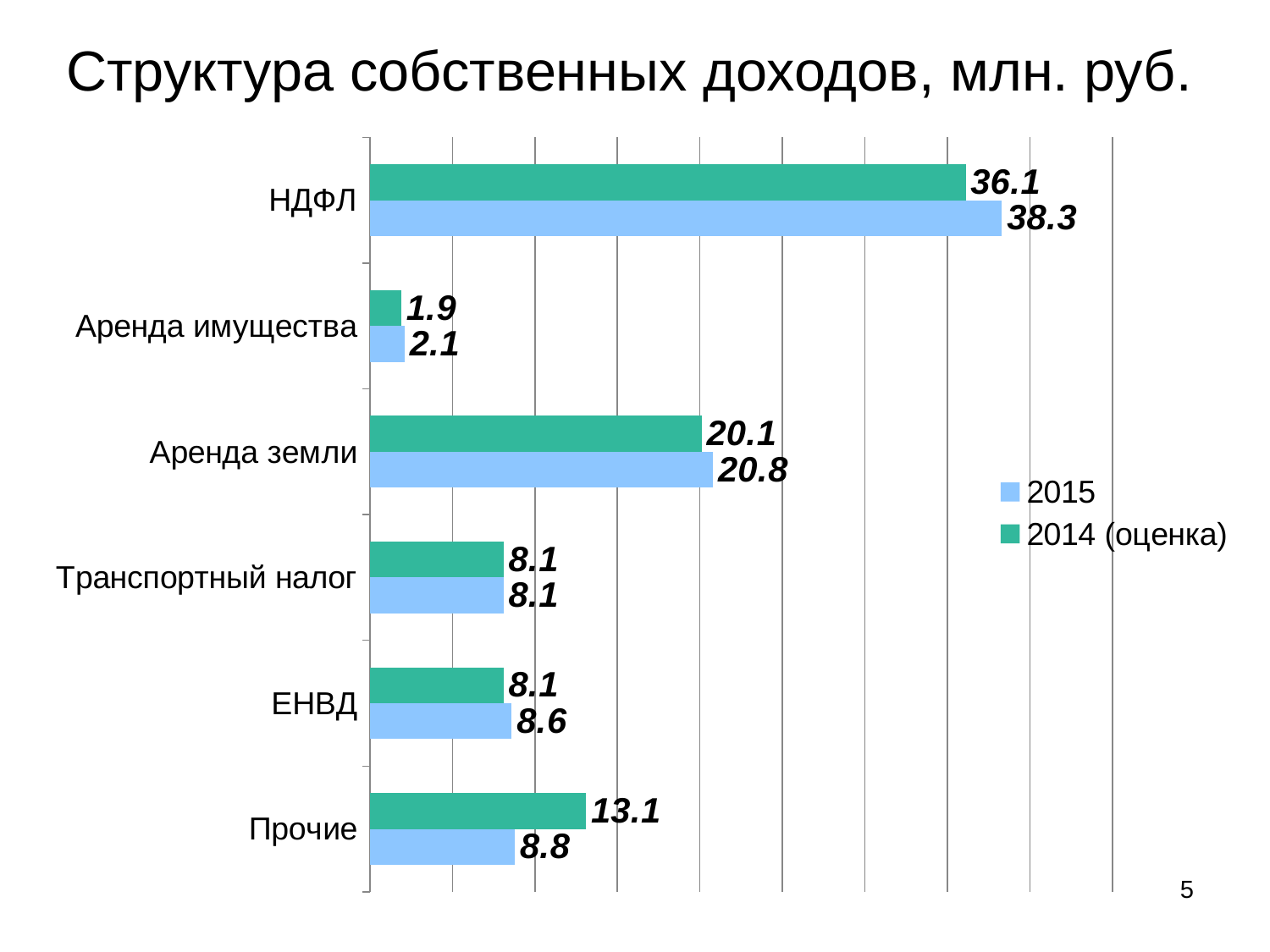
What is the difference between the 2015 and 2014 (оценка) values for НДФЛ? 2.2 What is the value for Аренда имущества in the 2014 (оценка) series? 1.9 What is the difference between the 2014 (оценка) and 2015 values for Прочие? 4.3 How many categories are shown on the chart? 6 What kind of chart is shown on the slide? Bar chart Which category has the highest value in the 2015 series? НДФЛ Which category has the lowest value in the 2014 (оценка) series? Аренда имущества What is the value for НДФЛ in the 2015 series? 38.3 What is the value for Аренда земли in the 2015 series? 20.8 What is the value for Прочие in the 2014 (оценка) series? 13.1 Which is larger for ЕНВД: the 2015 value or the 2014 (оценка) value? 2015 How many series does the legend list? 2